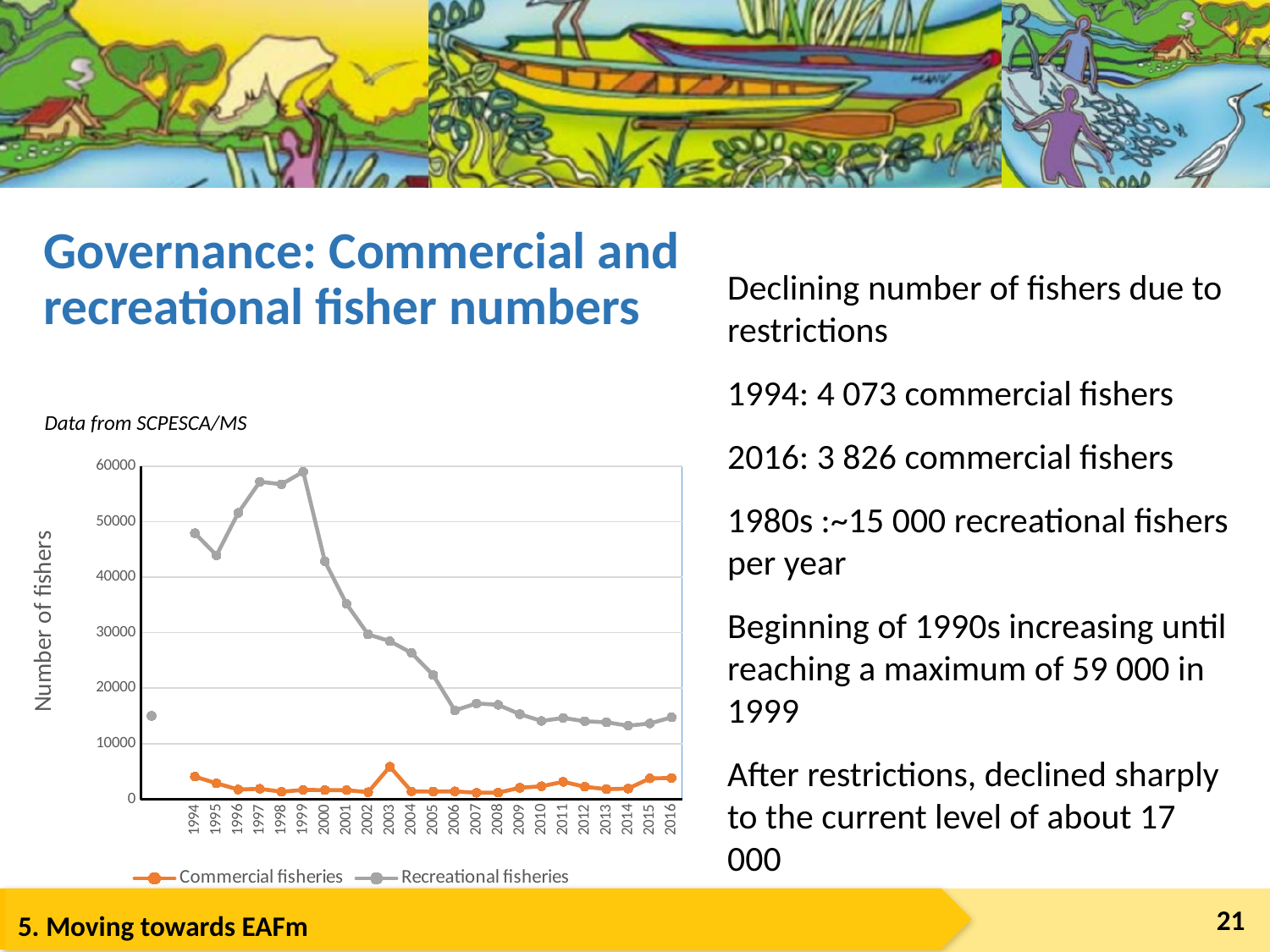
How many series does the chart legend list? 2 Which series has the larger value in 2003, Commercial fisheries or Recreational fisheries? Recreational fisheries Is the value for Recreational fisheries in 2000 greater or less than 40000? greater Is the value for Commercial fisheries in 2003 greater or less than 10000? less How many years are labelled along the x axis of the chart? 23 Which colour is used for the Commercial fisheries series in the chart? orange What kind of chart is shown on the slide? line chart Do the Recreational fisheries values rise or fall between 1999 and 2006? fall In which year does the Recreational fisheries series reach its highest value? 1999 Is the value for Recreational fisheries in 1999 greater or less than 50000? greater What is the label on the y axis of the chart? Number of fishers